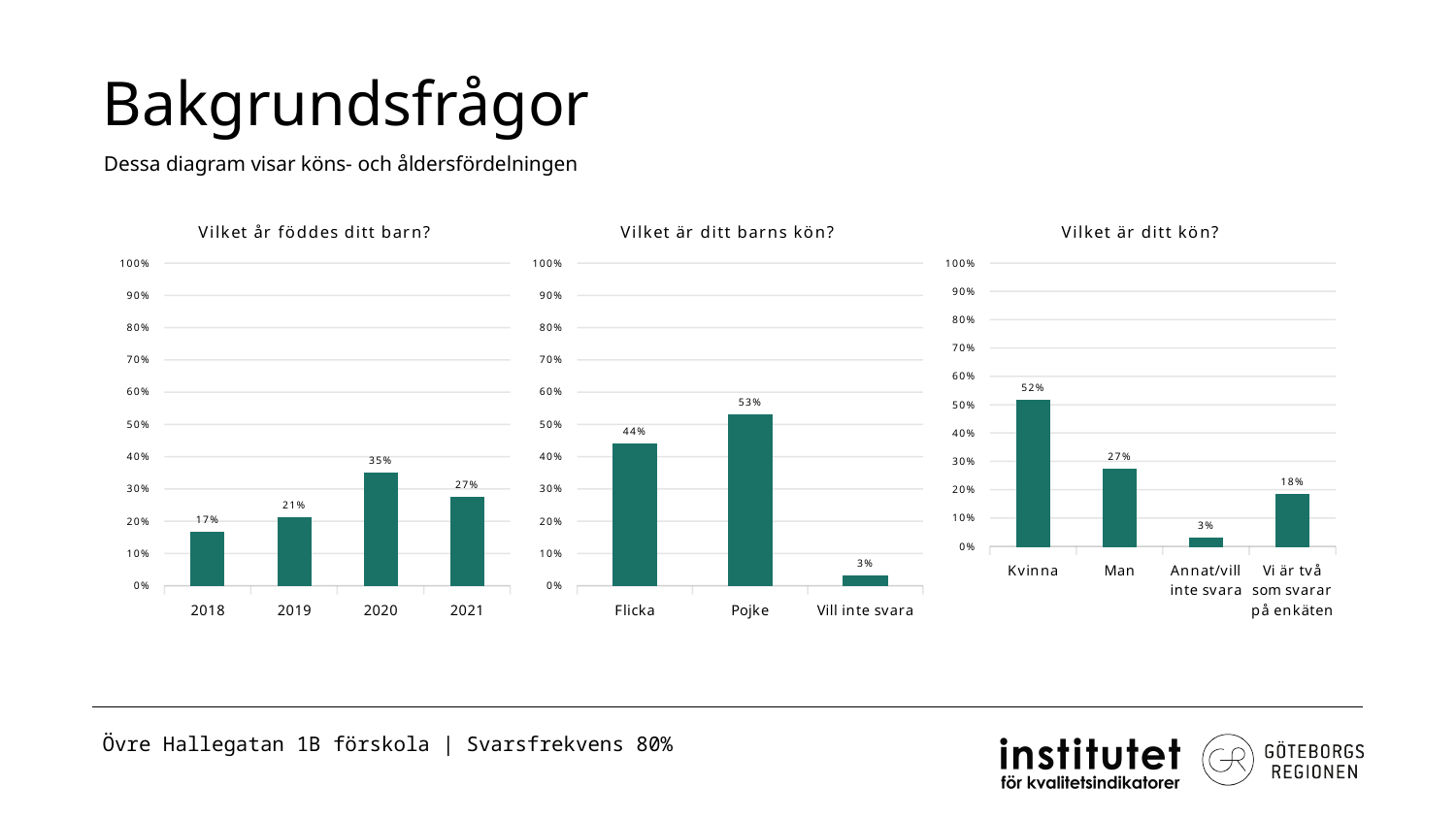
In the chart 'Vilket är ditt barns kön?', what is the value for Flicka? 44% In the chart 'Vilket är ditt barns kön?', which category has the highest value? Pojke In the chart 'Vilket är ditt kön?', what is the difference between the values for Kvinna and Man? 25% In the chart 'Vilket år föddes ditt barn?', what is the value for 2020? 35% In the chart 'Vilket år föddes ditt barn?', what is the difference between the values for 2020 and 2018? 18% In the chart 'Vilket år föddes ditt barn?', how many years are shown on the x axis? 4 In the chart 'Vilket år föddes ditt barn?', which year has the lowest value? 2018 In the chart 'Vilket är ditt kön?', which category has the lowest value? Annat/vill inte svara In the chart 'Vilket är ditt kön?', what is the value for Man? 27% In the chart 'Vilket är ditt kön?', which is larger, the value for Man or the value for Vi är två som svarar på enkäten? Man What kind of chart is 'Vilket är ditt barns kön?'? Bar chart In the chart 'Vilket är ditt barns kön?', is the value for Pojke greater or less than 50%? greater